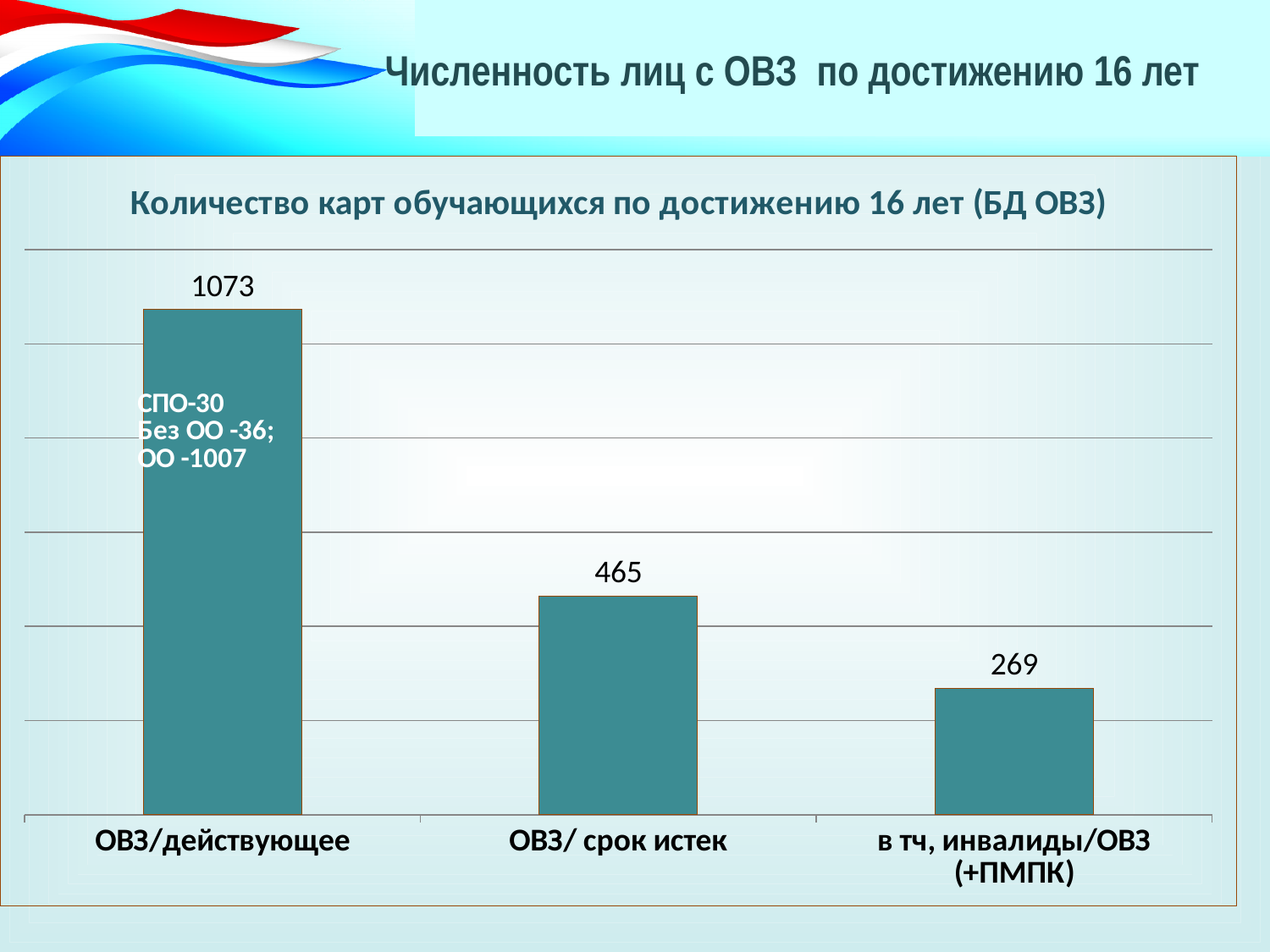
Do the values rise or fall from left to right across the categories? fall How many categories are shown on the chart? 3 What kind of chart is shown on the slide? bar chart Which category has the lowest value? в тч, инвалиды/ОВЗ (+ПМПК) What is the value for в тч, инвалиды/ОВЗ (+ПМПК)? 269 Which is larger, the value for ОВЗ/ срок истек or the value for в тч, инвалиды/ОВЗ (+ПМПК)? ОВЗ/ срок истек What is the difference between the values for ОВЗ/ срок истек and в тч, инвалиды/ОВЗ (+ПМПК)? 196 What is the difference between the values for ОВЗ/действующее and ОВЗ/ срок истек? 608 What is the value for ОВЗ/ срок истек? 465 What is the title of the chart? Количество карт обучающихся по достижению 16 лет (БД ОВЗ) What is the value for ОВЗ/действующее? 1073 Which category has the highest value? ОВЗ/действующее